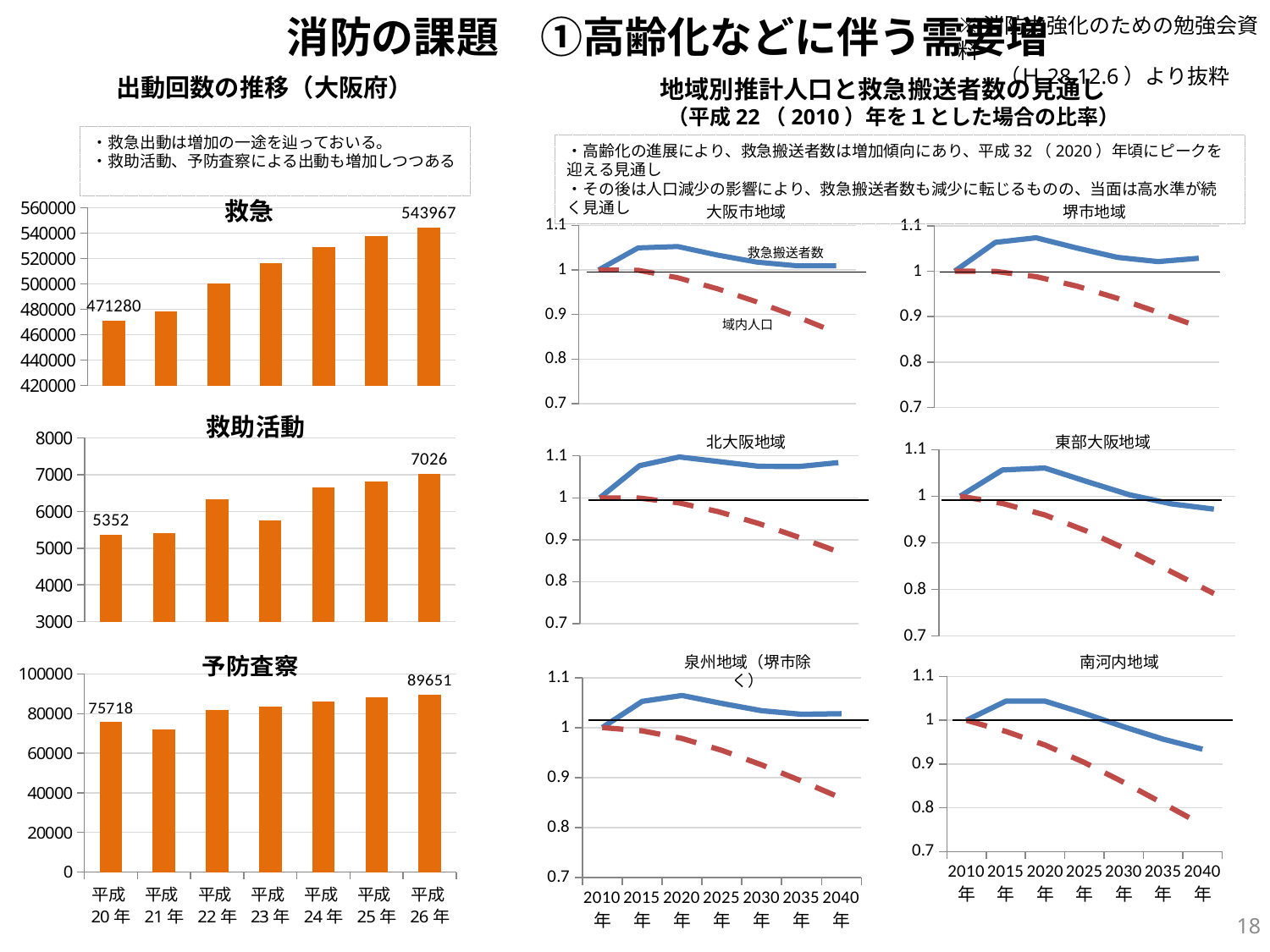
In the 救急 bar chart, what is the value for 平成26年? 543967 In the 予防査察 bar chart, is the value for 平成21年 greater or less than 80000? less In the 救助活動 bar chart, what is the value for 平成26年? 7026 In the 東部大阪地域 line chart, does the dashed 域内人口 line rise or fall from 2010 to 2040? fall How many years are shown on the x axis of the 救助活動 bar chart? 7 In the 救急 bar chart, what is the difference between the values for 平成26年 and 平成20年? 72687 In the 予防査察 bar chart, what is the value for 平成20年? 75718 In the 救急 bar chart, what is the value for 平成20年? 471280 In the 予防査察 bar chart, which year has the lowest value? 平成21年 In the 救助活動 bar chart, what is the difference between the values for 平成26年 and 平成20年? 1674 In the 救急 bar chart, is the value for 平成23年 greater or less than 500000? greater In the 救急 bar chart, which year has the highest value? 平成26年